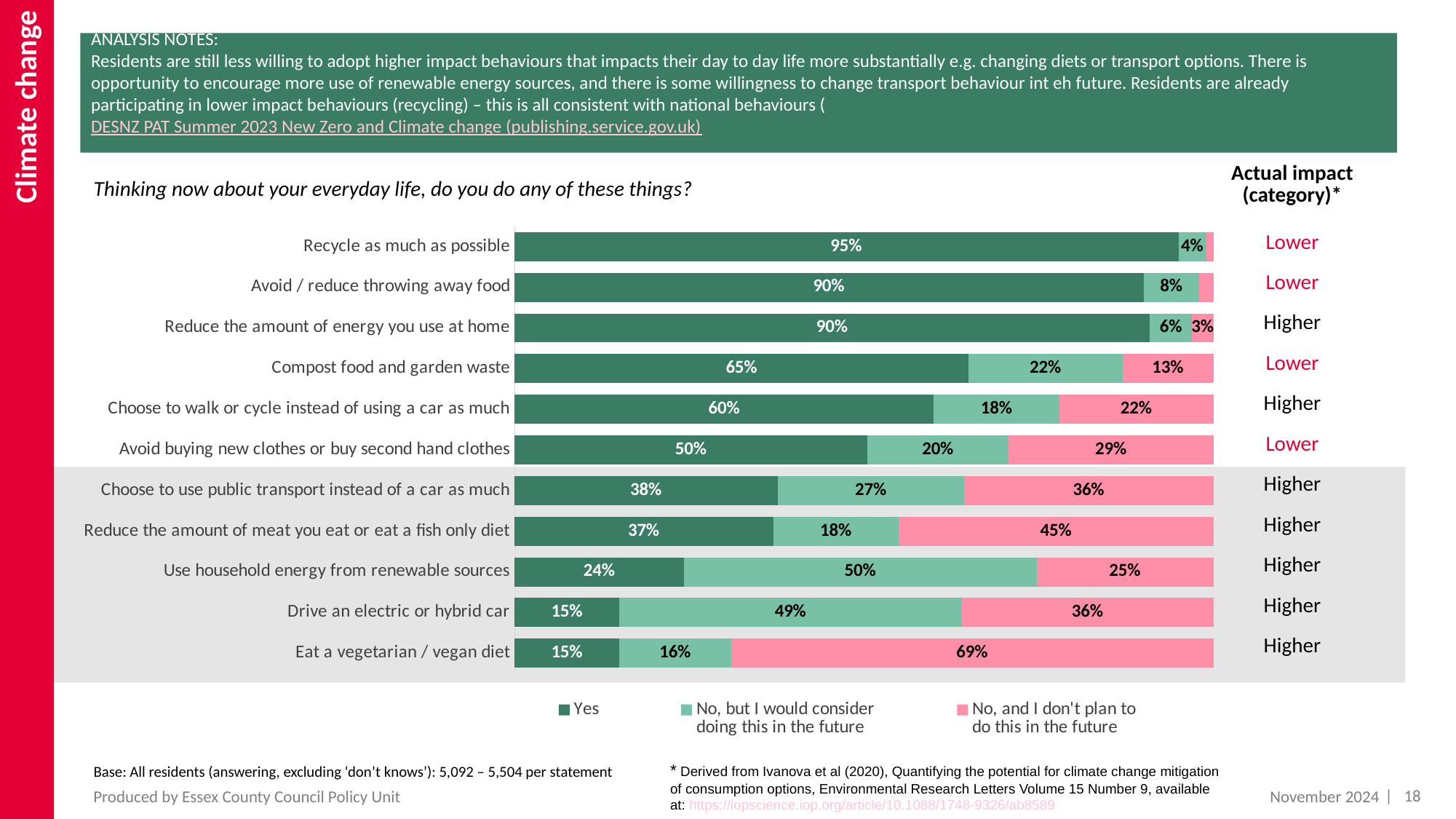
What percentage of residents answered 'Yes' to 'Compost food and garden waste'? 65% How many behaviours (categories) are plotted in the chart? 11 What is the difference in 'Yes' percentage between 'Compost food and garden waste' and 'Choose to walk or cycle instead of using a car as much'? 5 percentage points Which behaviour has the highest 'Yes' percentage? Recycle as much as possible What kind of chart is shown on the slide? Stacked bar chart What percentage answered 'No, and I don't plan to do this in the future' for 'Reduce the amount of meat you eat or eat a fish only diet'? 45% How many series does the chart legend list? 3 What is the total of the three labelled segments for 'Compost food and garden waste'? 100% What percentage answered 'No, but I would consider doing this in the future' for 'Use household energy from renewable sources'? 50% Which has a larger 'No, and I don't plan to do this in the future' share: 'Drive an electric or hybrid car' or 'Eat a vegetarian / vegan diet'? Eat a vegetarian / vegan diet What is the question shown as the chart's title? Thinking now about your everyday life, do you do any of these things? Which behaviour has the highest 'No, and I don't plan to do this in the future' percentage? Eat a vegetarian / vegan diet